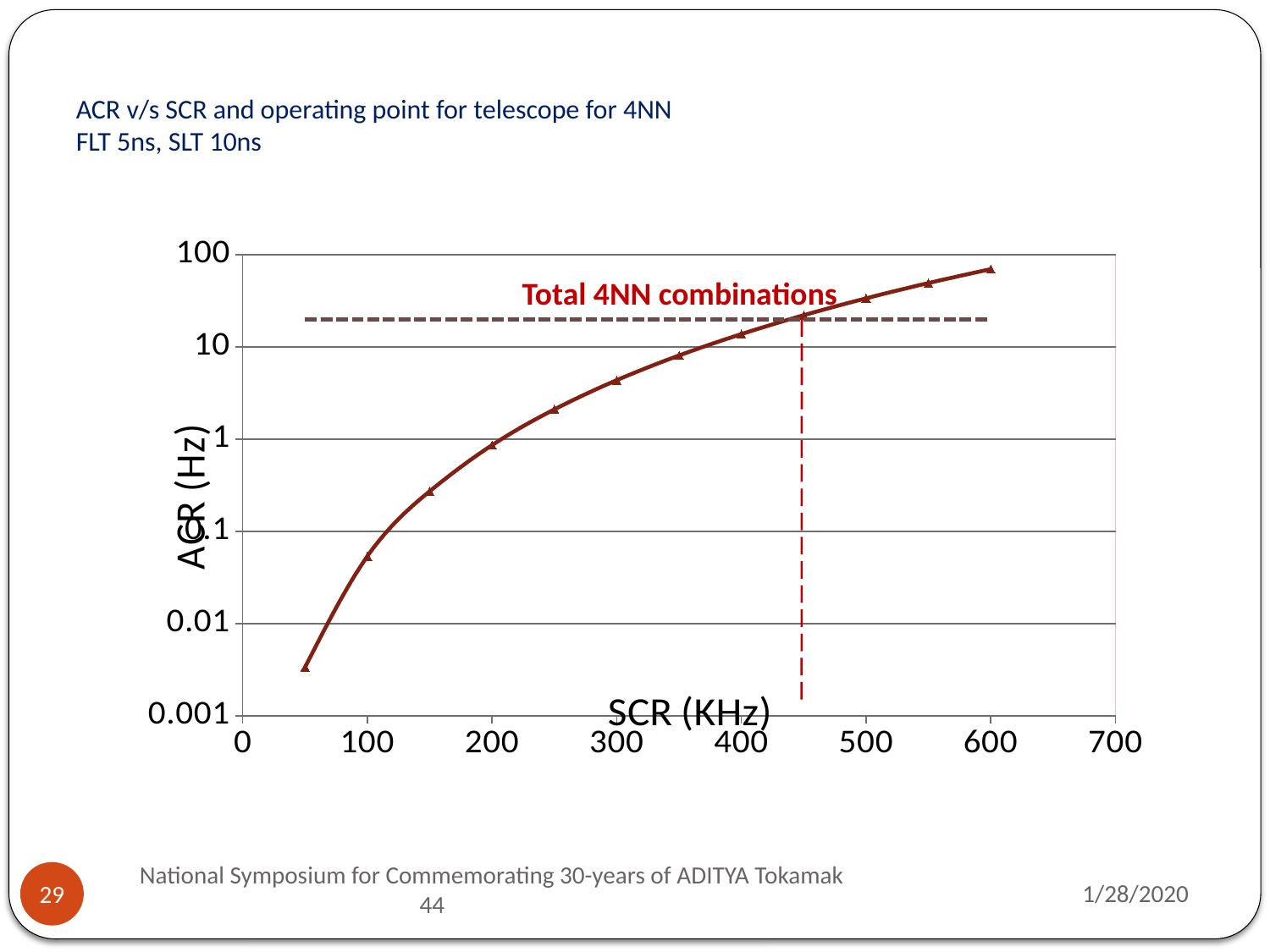
What is the label on the y axis of the chart? ACR (Hz) What text labels the horizontal dashed line on the chart? Total 4NN combinations Is the ACR value at SCR 500 KHz greater or less than 10 Hz? greater Is the ACR value at SCR 50 KHz greater or less than 0.01 Hz? less How many data points are plotted on the curve? 12 Is the ACR value at SCR 100 KHz greater or less than 0.1 Hz? less At which SCR value is the plotted ACR highest? 600 At which SCR value is the plotted ACR lowest? 50 What kind of chart is shown on the slide? line chart Does ACR rise or fall as SCR increases along the x axis? rises